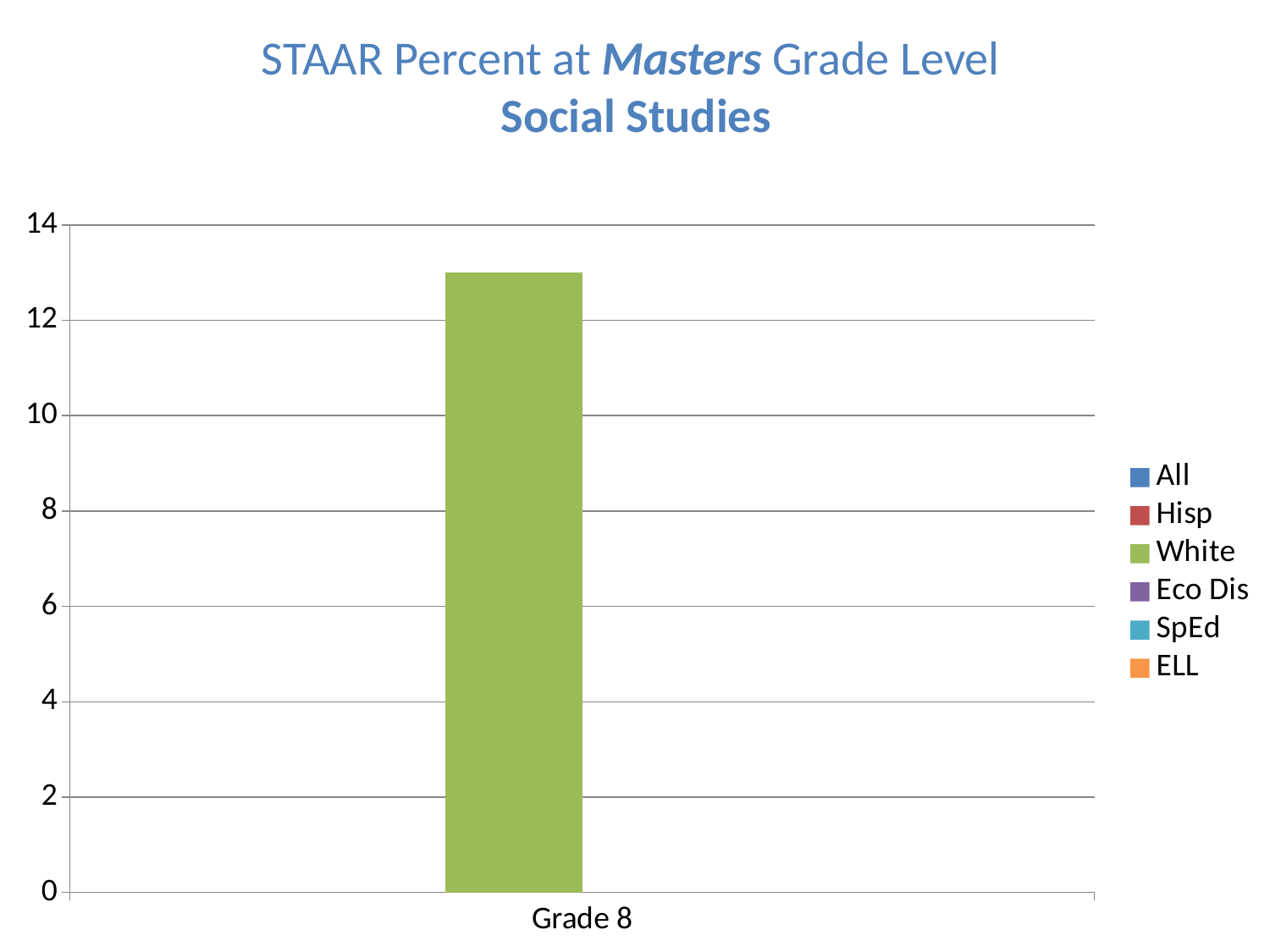
How many categories are shown on the x axis? 1 Which series has the highest value for Grade 8? White What kind of chart is shown on the slide? bar chart What is the title of the chart? STAAR Percent at Masters Grade Level Social Studies Is the value for White in Grade 8 greater or less than 14? less Is the value for White in Grade 8 greater or less than 10? greater How many series does the legend list? 6 What is the category label on the x axis? Grade 8 What is the highest value shown on the y axis? 14 Is the value for White in Grade 8 greater or less than 12? greater